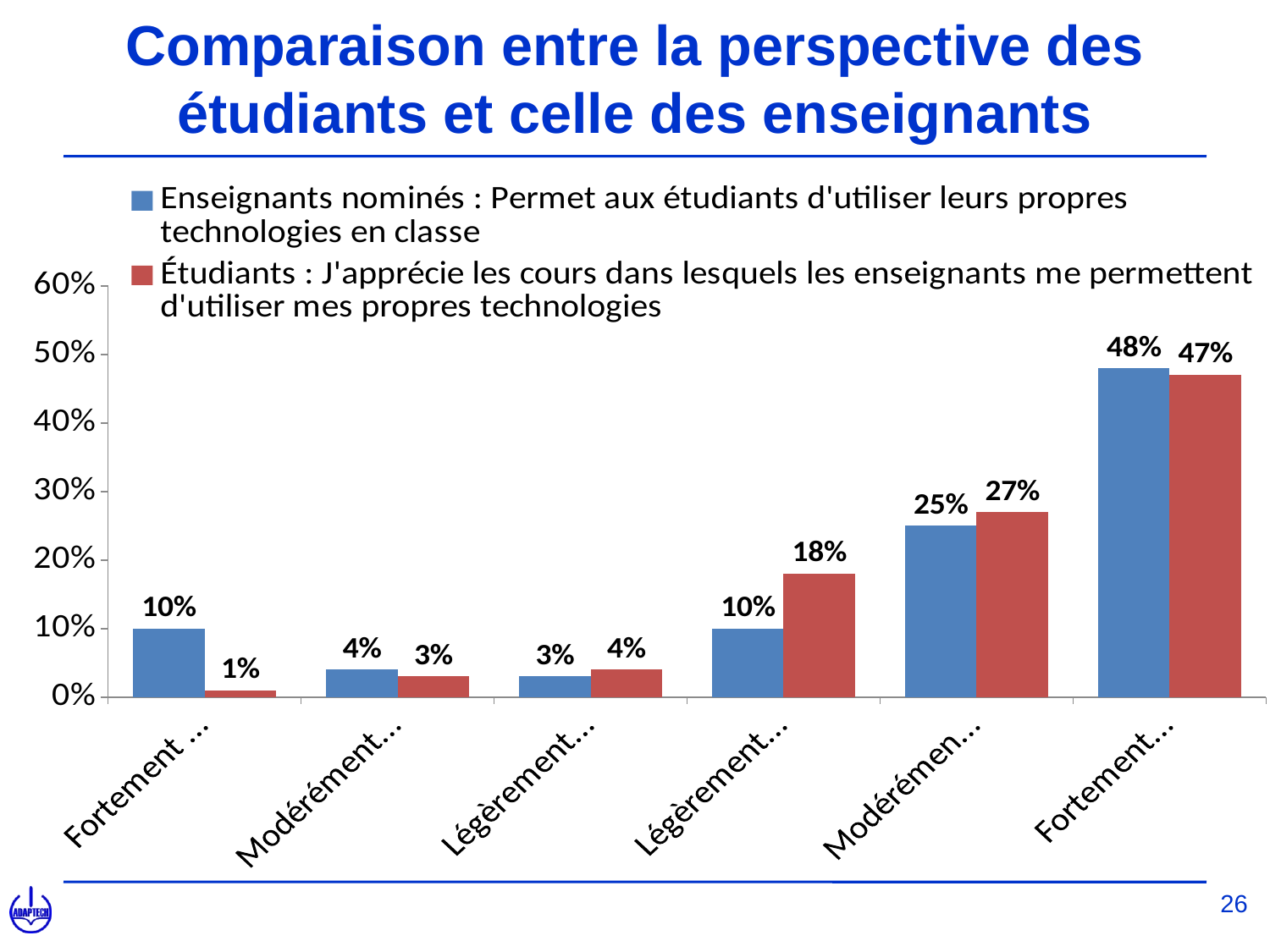
How many categories are shown along the x axis? 6 Do the values of the 'Étudiants' series rise or fall from the fourth category to the sixth category? rise What is the value of the 'Enseignants nominés' series for the rightmost category? 48% How many series does the legend list? 2 What type of chart is shown on the slide? Bar chart In the fifth category from the left, which series has the larger value? Étudiants What is the highest value shown for the 'Étudiants' series? 47% What is the lowest value shown for the 'Enseignants nominés' series? 3% In the fourth category from the left, what is the difference between the 'Étudiants' value and the 'Enseignants nominés' value? 8 percentage points What colour represents the 'Étudiants' series in the chart? Red What is the value of the 'Étudiants' series for the leftmost category? 1% Is the 'Enseignants nominés' value for the rightmost category greater or less than 40%? greater